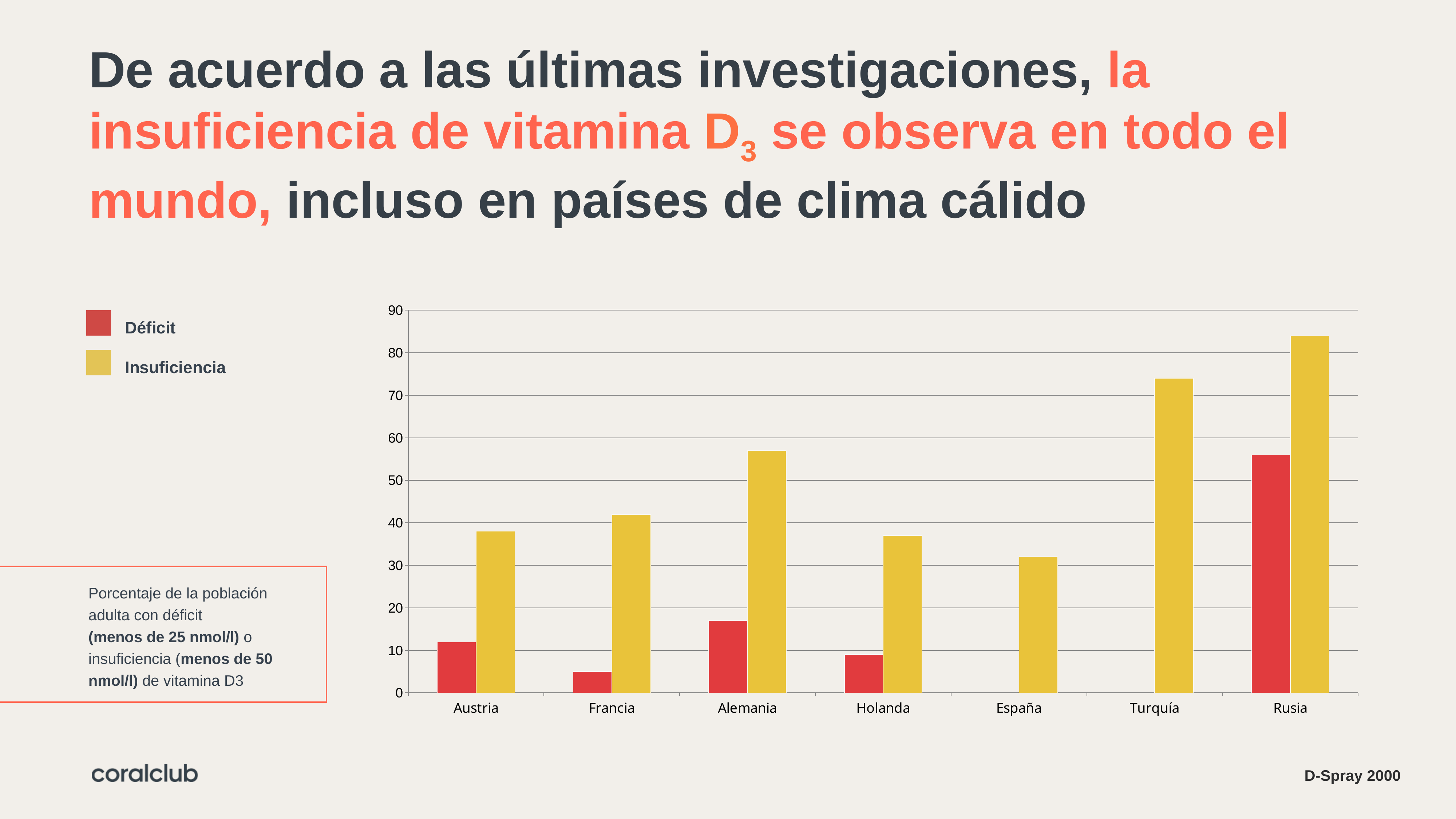
Which country has the highest Déficit value? Rusia How many countries are shown on the x axis of the chart? 7 What kind of chart is shown on the slide? bar chart Is the Déficit value for Francia greater or less than 10? less Is the Déficit value for Rusia greater or less than 50? greater Is the Insuficiencia value for Turquía greater or less than 70? greater How many series does the chart's legend list? 2 Which is larger, the Insuficiencia value for Alemania or for Francia? Alemania Which country has the lowest Insuficiencia value? España Which country has the highest Insuficiencia value? Rusia What colour are the Insuficiencia bars in the chart? yellow